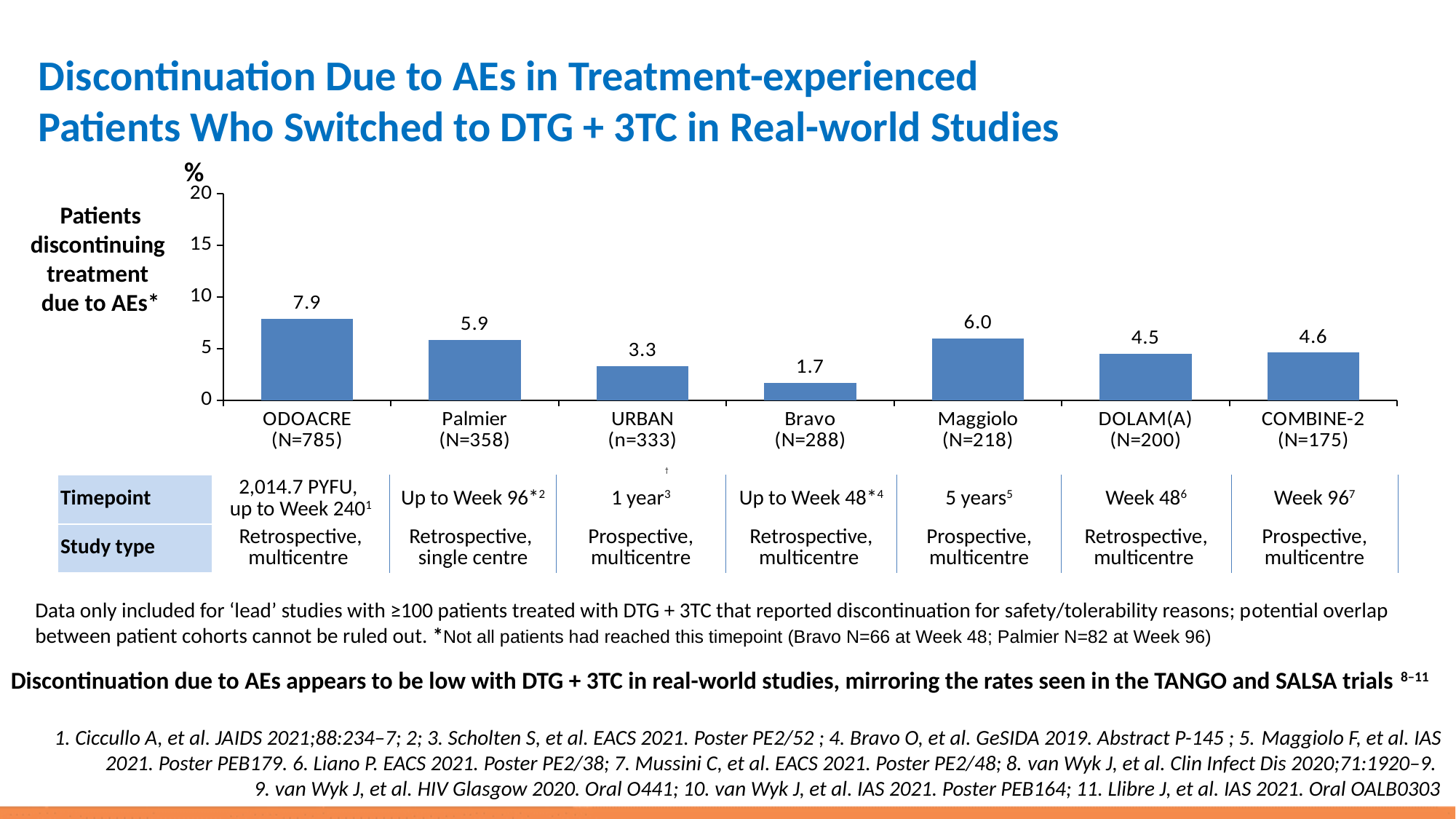
What is the difference between the values for ODOACRE and Palmier? 2.0 What is the value shown for the Bravo study? 1.7 What is the value shown for the Maggiolo study? 6.0 What kind of chart is shown on the slide? Bar chart How many studies are shown in the chart? 7 Which study has the lowest percentage of patients discontinuing treatment due to AEs? Bravo Is the value for Maggiolo greater or less than 5? greater Which study has the highest percentage of patients discontinuing treatment due to AEs? ODOACRE What is the value shown for COMBINE-2? 4.6 What is the unit shown on the y axis of the chart? % What percentage of patients discontinued treatment due to AEs in the ODOACRE study? 7.9 Which has a higher value, URBAN or DOLAM(A)? DOLAM(A)